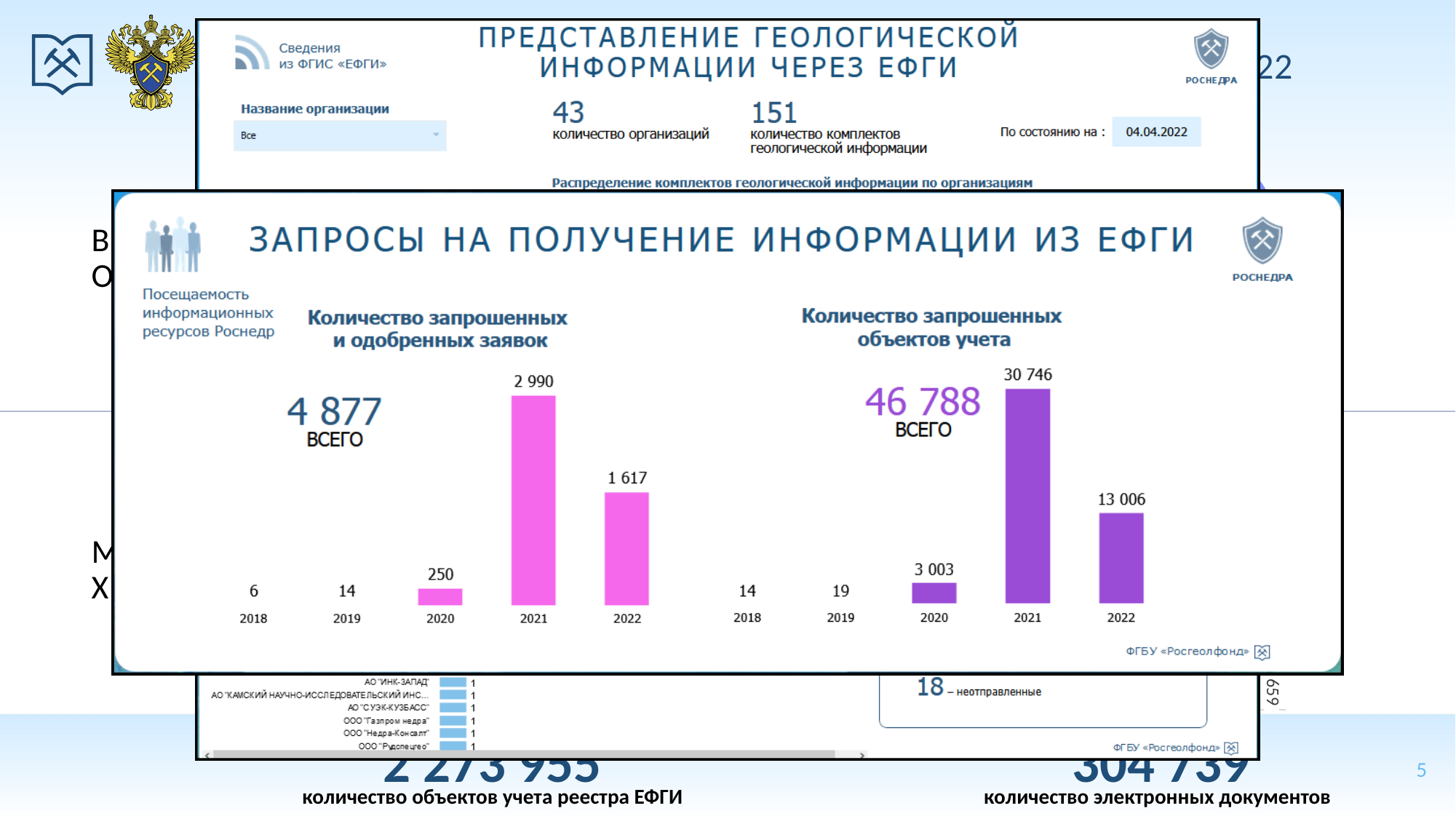
In the chart 'Количество запрошенных объектов учета', what is the value for 2022? 13 006 In the chart 'Количество запрошенных объектов учета', what is the difference between the values for 2021 and 2022? 17 740 What kind of chart is 'Количество запрошенных объектов учета'? bar chart In the chart 'Количество запрошенных и одобренных заявок', which year has the lowest value? 2018 In the chart 'Количество запрошенных и одобренных заявок', what is the difference between the values for 2021 and 2022? 1 373 In the chart 'Количество запрошенных объектов учета', which year has the highest value? 2021 What total ('ВСЕГО') is shown next to the chart 'Количество запрошенных и одобренных заявок'? 4 877 In the chart 'Количество запрошенных и одобренных заявок', what is the value for 2021? 2 990 What total ('ВСЕГО') is shown next to the chart 'Количество запрошенных объектов учета'? 46 788 How many years are shown on the x axis of the chart 'Количество запрошенных и одобренных заявок'? 5 In the chart 'Количество запрошенных объектов учета', which is larger, the value for 2019 or the value for 2020? 2020 In the chart 'Количество запрошенных и одобренных заявок', what is the value for 2020? 250